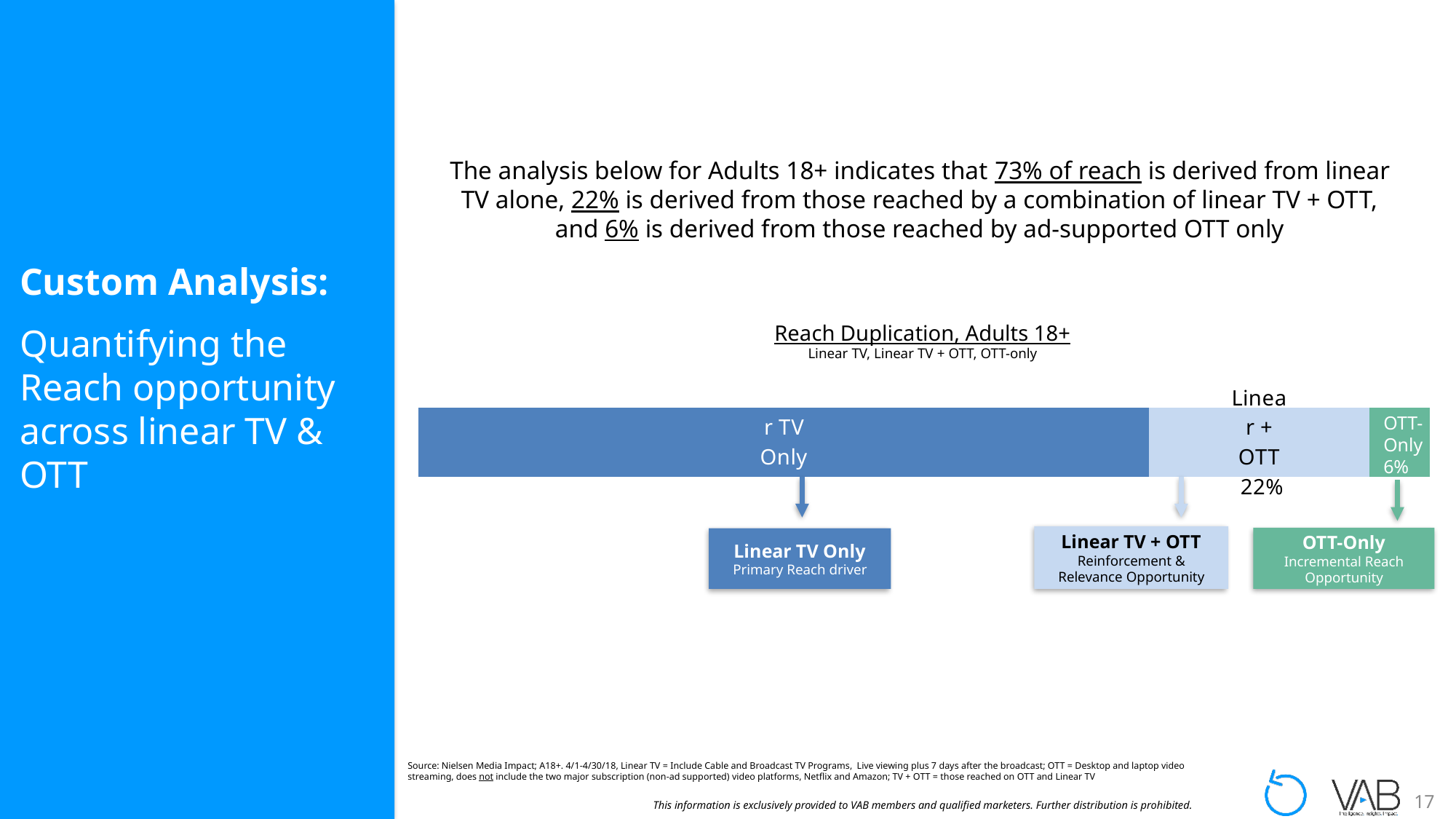
How many segments make up the stacked bar? 3 Which segment of the bar is the largest? Linear TV Only What colour is the OTT-Only segment of the bar? Green What is the value shown for the OTT-Only segment of the bar? 6% Which segment of the bar is the smallest? OTT-Only What is the title of the chart? Reach Duplication, Adults 18+ What is the value shown for the Linear TV + OTT segment of the bar? 22% What kind of chart is shown under the title "Reach Duplication, Adults 18+"? Stacked bar chart According to the slide, what share of reach is derived from linear TV alone? 73% What is the total of the three segments in the stacked bar? 101% What is the difference between the Linear TV + OTT segment and the OTT-Only segment? 16% Which is larger, the Linear TV + OTT segment or the OTT-Only segment? Linear TV + OTT